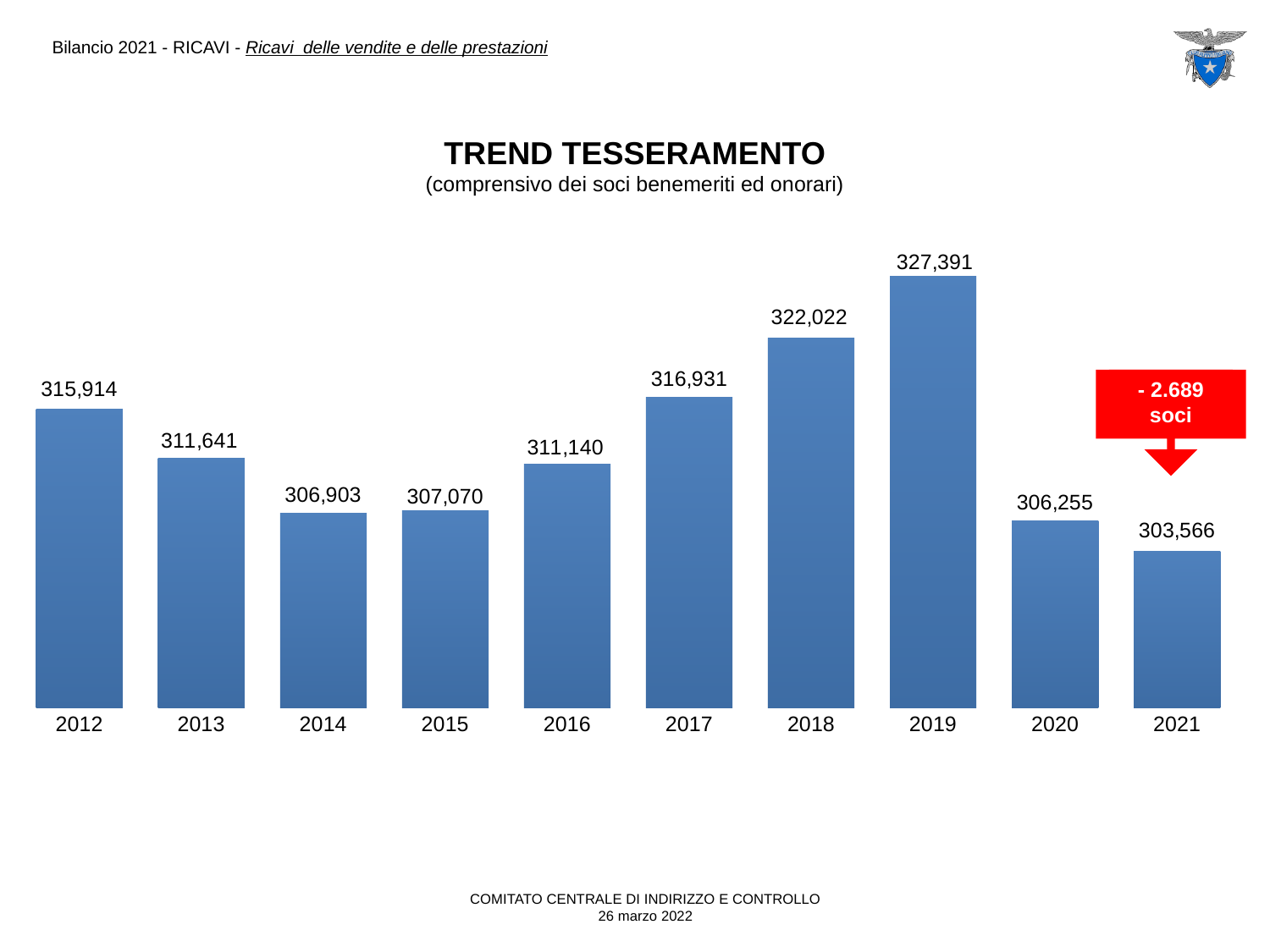
What is the value shown for 2015? 307,070 Which is larger, the value for 2014 or the value for 2015? 2015 Do the values rise or fall from 2016 to 2019? Rise What is the difference between the values for 2019 and 2021? 23,825 Which year has the highest value? 2019 Which is larger, the value for 2012 or the value for 2017? 2017 How many years are shown on the x axis? 10 Which year has the lowest value? 2021 What is the difference between the values for 2020 and 2021? 2,689 What is the value shown for 2021? 303,566 What is the value shown for 2019? 327,391 What kind of chart is shown on the slide? Bar chart